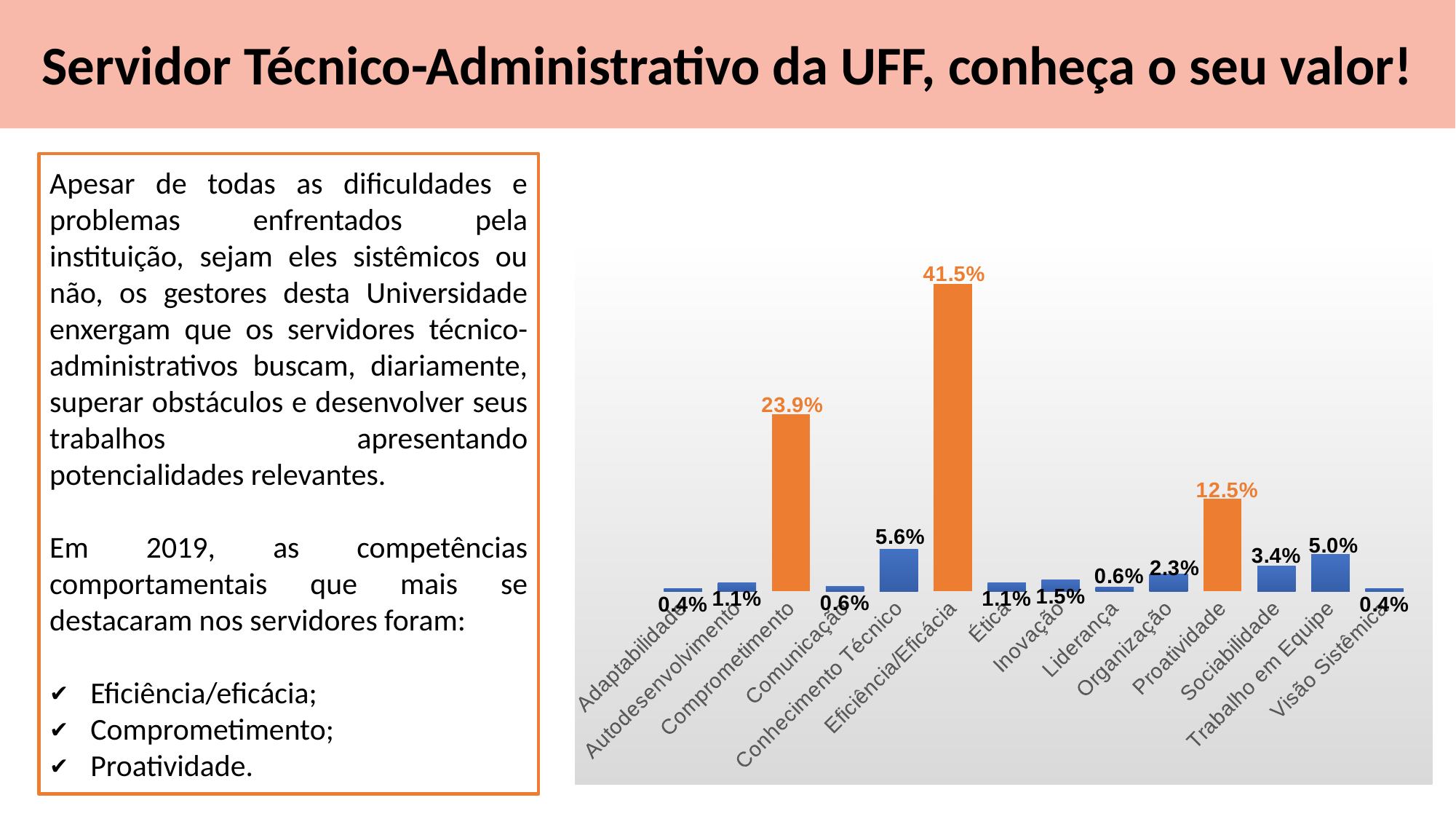
What is the value for Trabalho em Equipe? 5.0% Which is larger, the value for Conhecimento Técnico or the value for Trabalho em Equipe? Conhecimento Técnico What is the difference between the values for Proatividade and Sociabilidade? 9.1% Which category has the highest value? Eficiência/Eficácia What is the value for Conhecimento Técnico? 5.6% How many categories are shown on the x axis of the chart? 14 What is the value for Comprometimento? 23.9% How many bars in the chart are coloured orange? 3 What is the value for Proatividade? 12.5% What kind of chart is shown on the slide? bar chart What is the value for Eficiência/Eficácia? 41.5% What is the difference between the values for Eficiência/Eficácia and Comprometimento? 17.6%